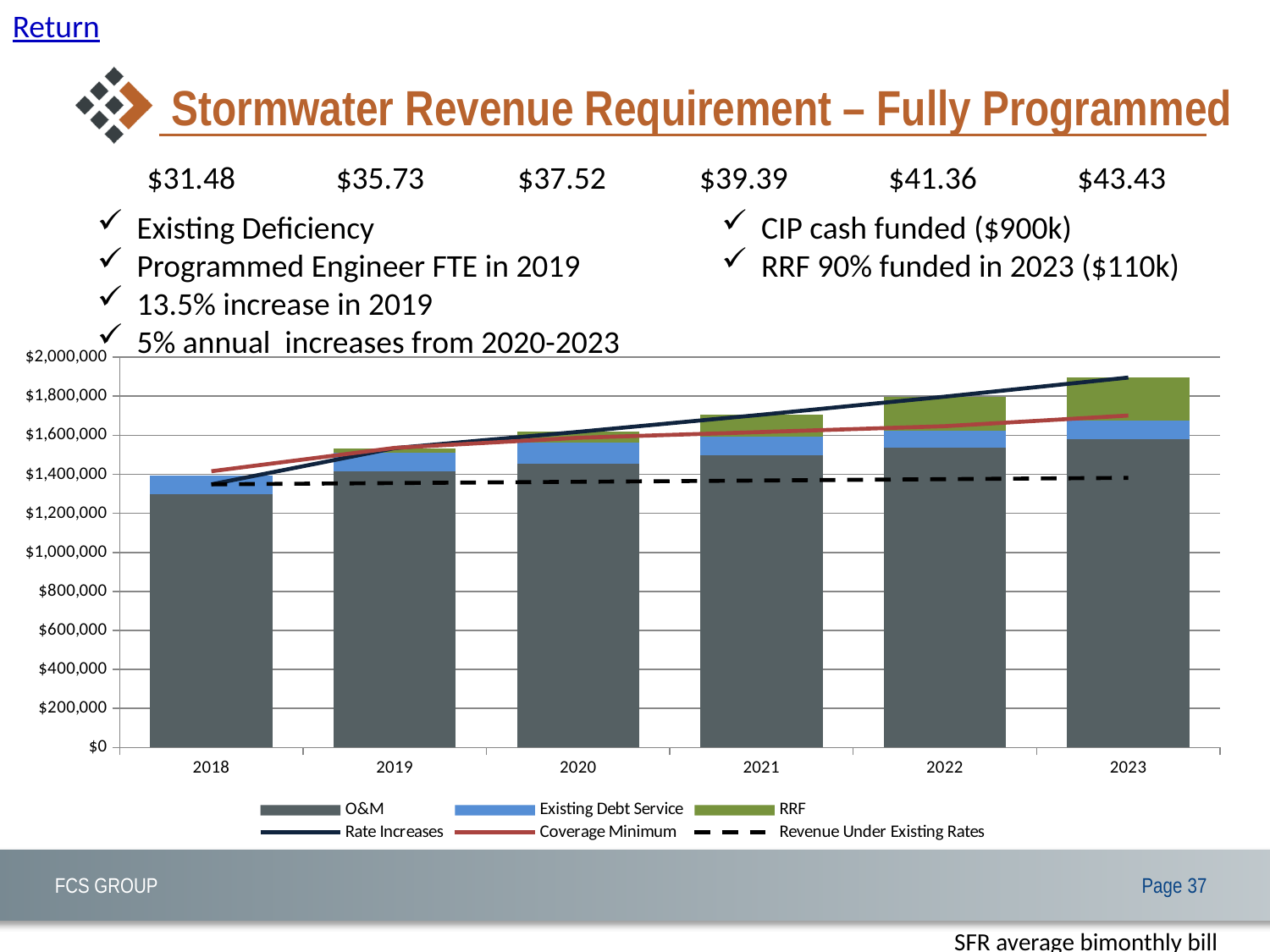
Which year has the tallest stacked bar? 2023 Which colour represents RRF in the chart legend? Green Which year has the shortest stacked bar? 2018 Is the total stacked bar for 2023 greater or less than $1,800,000? greater What kind of chart is shown on the slide? Stacked bar chart with line series Which series is drawn as a dashed line in the chart? Revenue Under Existing Rates How many years are shown on the x axis of the chart? 6 How many series does the chart legend list? 6 Do the stacked bar totals rise or fall from 2018 to 2023? rise Is the total stacked bar for 2019 greater or less than $1,600,000? less Is the O&M value for 2018 greater or less than $1,400,000? less